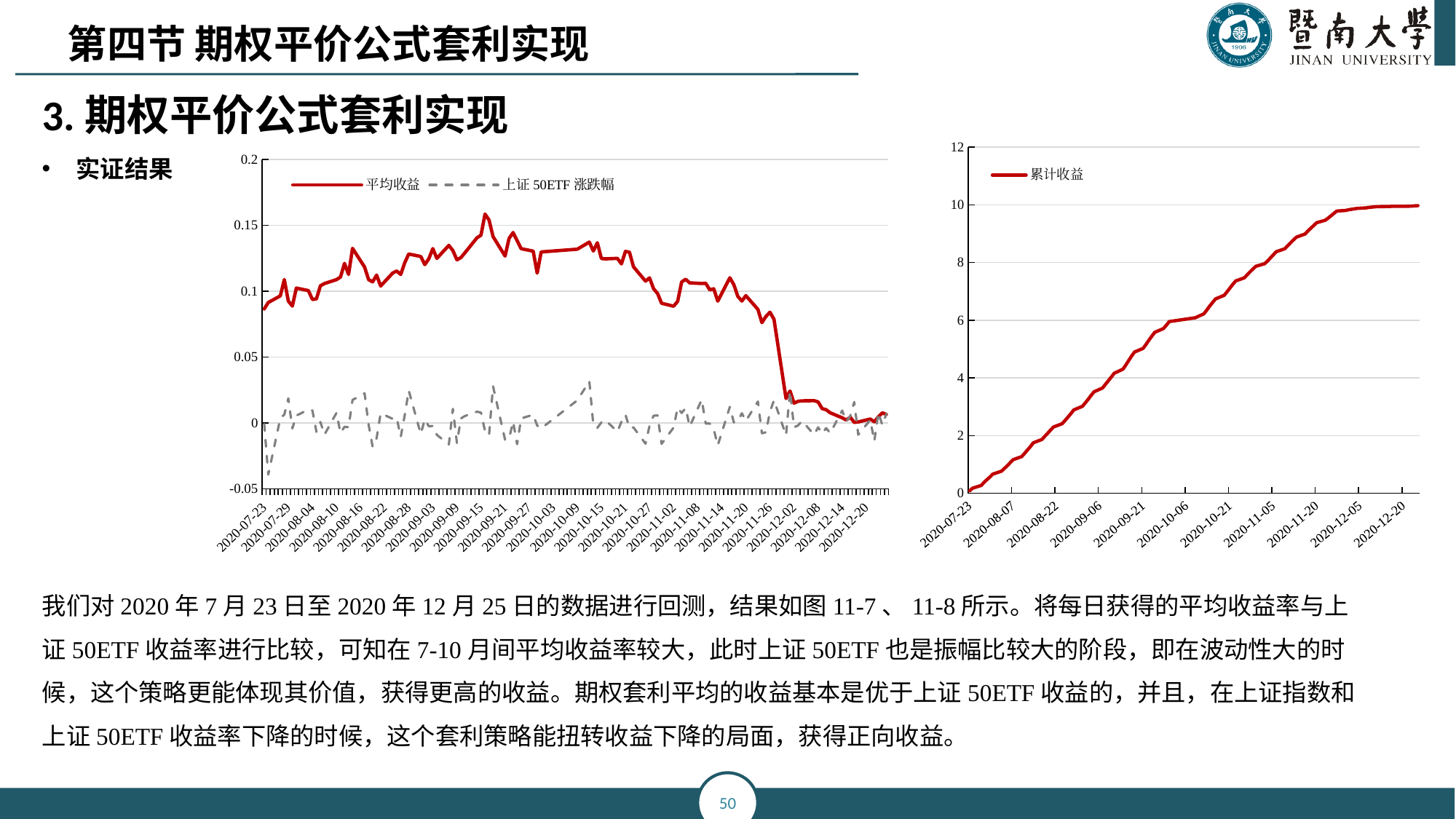
How many series does the legend of the left chart list? 2 In the left chart, around 2020-09-15, which series has the larger value, 平均收益 or 上证 50ETF 涨跌幅? 平均收益 In the left chart, which series is drawn as a grey dashed line? 上证 50ETF 涨跌幅 In the left chart, is the value of 平均收益 at 2020-07-23 greater or less than 0.1? less What kind of chart is the left chart on the slide? line chart What is the name of the series shown in the right chart? 累计收益 In the left chart, is the peak value of 平均收益 around 2020-09-15 greater or less than 0.15? greater In the right chart, do the values of 累计收益 rise or fall from 2020-07-23 to 2020-12-20? rise In the right chart, is the value of 累计收益 at 2020-08-22 greater or less than 2? greater What kind of chart is the right chart on the slide? line chart How many series does the legend of the right chart list? 1